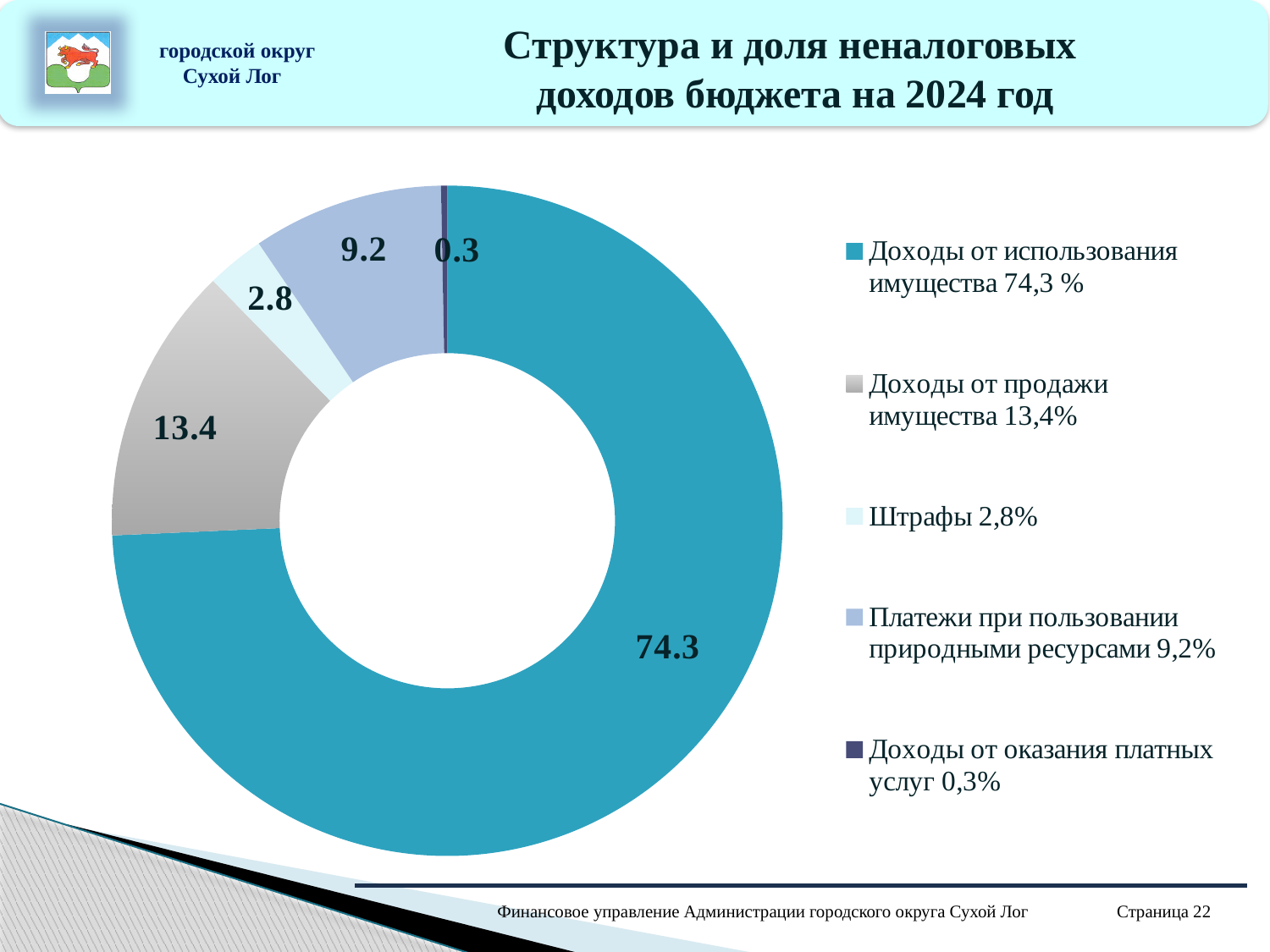
What is the data label for the slice 'Платежи при пользовании природными ресурсами'? 9.2 What is the data label for the slice 'Штрафы'? 2.8 Which is larger: the slice for 'Штрафы' or the slice for 'Платежи при пользовании природными ресурсами'? Платежи при пользовании природными ресурсами What is the data label for the slice 'Доходы от оказания платных услуг'? 0.3 Which category has the smallest slice of the chart? Доходы от оказания платных услуг What is the title of the slide containing the chart? Структура и доля неналоговых доходов бюджета на 2024 год What is the data label for the slice 'Доходы от продажи имущества'? 13.4 How many slices does the chart have? 5 Which category has the largest slice of the chart? Доходы от использования имущества What is the data label for the slice 'Доходы от использования имущества'? 74.3 What is the difference between the values for 'Доходы от продажи имущества' and 'Платежи при пользовании природными ресурсами'? 4.2 What type of chart is shown on the slide? Doughnut (pie) chart